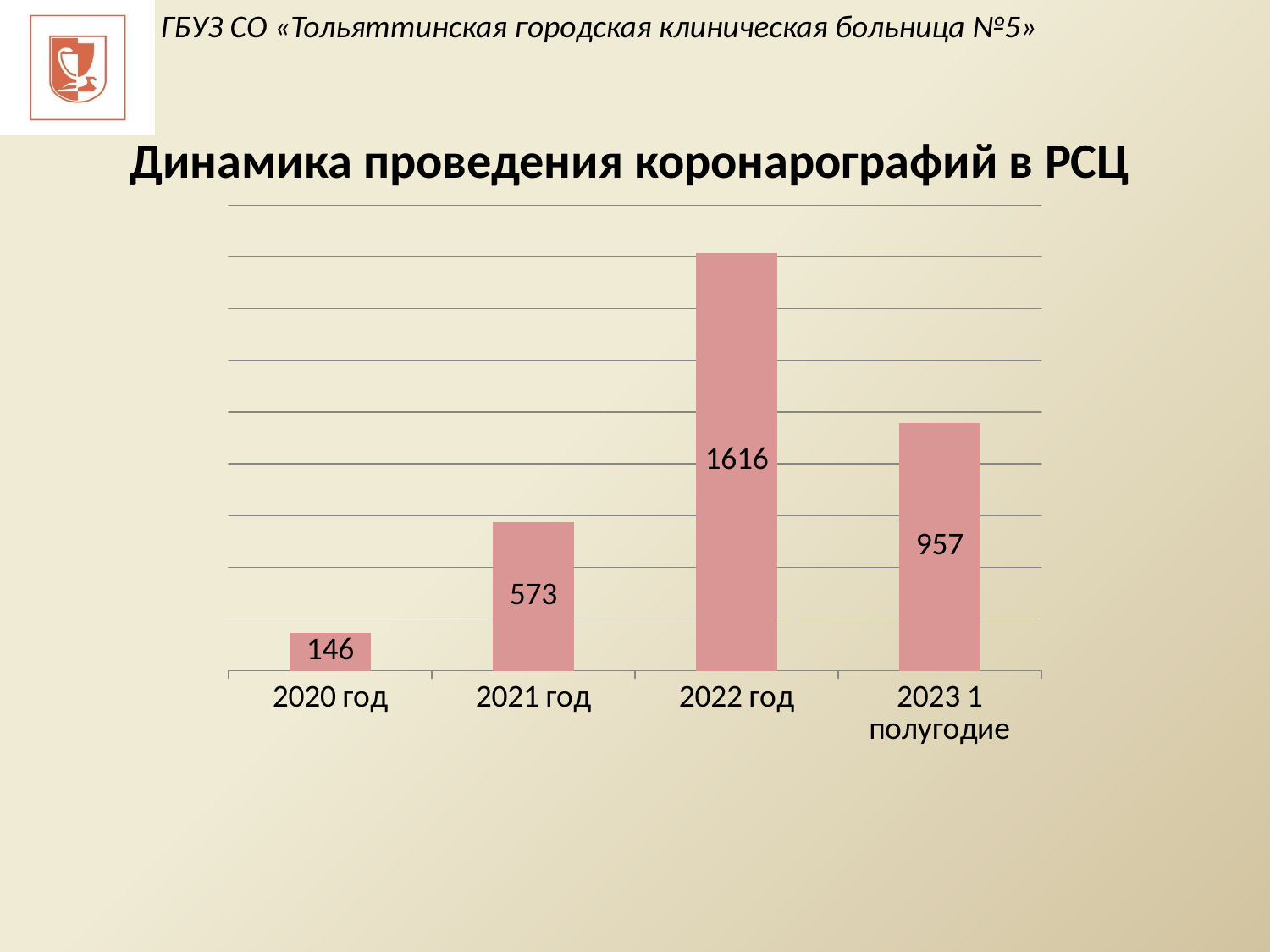
Which category has the highest value? 2022 год What is the value for 2022 год? 1616 What is the value for 2023 1 полугодие? 957 Which category has the lowest value? 2020 год What is the value for 2020 год? 146 Which is larger, the value for 2021 год or the value for 2023 1 полугодие? 2023 1 полугодие What kind of chart is shown on the slide? bar chart What is the difference between the values for 2022 год and 2021 год? 1043 What is the difference between the values for 2023 1 полугодие and 2020 год? 811 How many categories are shown on the x axis? 4 What is the value for 2021 год? 573 What is the title of the chart? Динамика проведения коронарографий в РСЦ